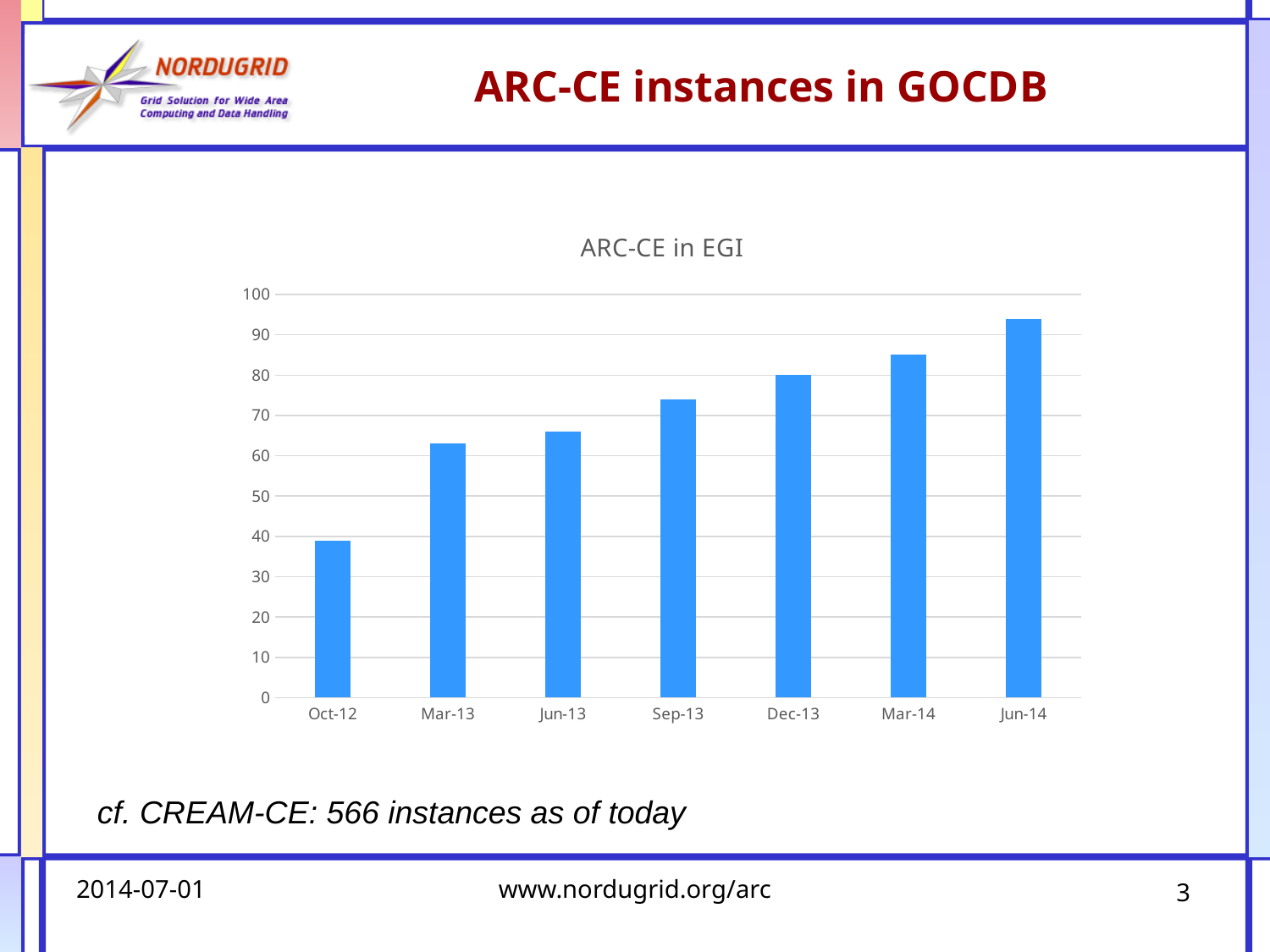
What colour are the bars in the chart? blue How many categories (dates) are shown on the x axis of the chart? 7 What kind of chart is shown on the slide? bar chart Is the value for Oct-12 greater or less than 50? less Which date has the highest value in the chart? Jun-14 Which is larger, the value for Mar-14 or the value for Dec-13? Mar-14 Is the value for Sep-13 greater or less than 80? less Is the value for Mar-13 greater or less than 60? greater Do the values rise or fall from Oct-12 to Jun-14? rise What is the title of the chart? ARC-CE in EGI Which date has the lowest value in the chart? Oct-12